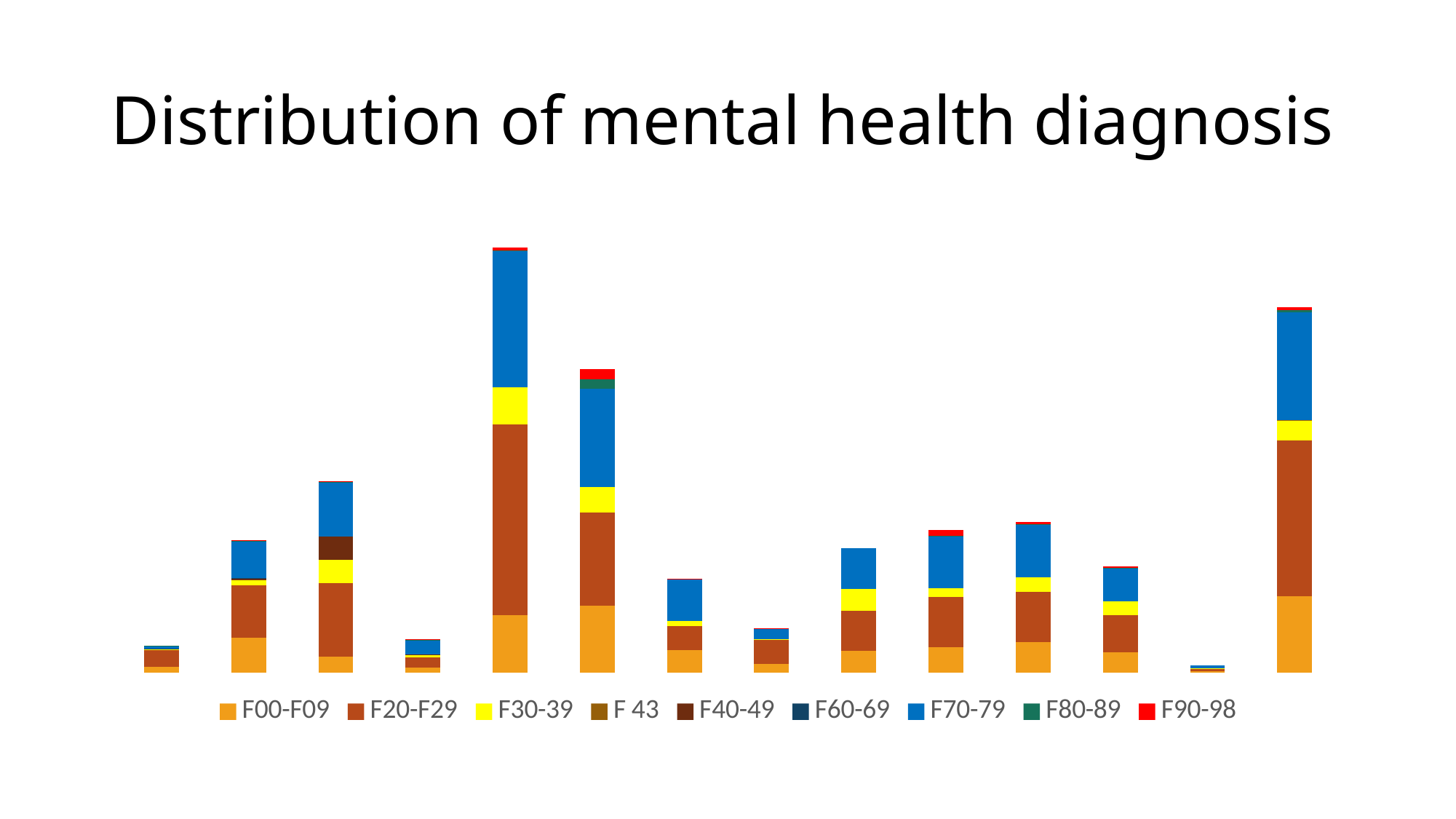
Which legend entry is shown in red? F90-98 Is the fifth bar from the left taller or shorter than the rightmost bar? Taller Which series forms the bottom segment of each stacked bar? F00-F09 What kind of chart is shown on the slide? Stacked bar chart Which bar, counted from the left, is the tallest? The fifth bar How many series does the legend list? 9 Is the second bar from the left taller or shorter than the third bar from the left? Shorter Which bar, counted from the left, is the shortest? The thirteenth bar How many bars are plotted in the chart? 14 What is the title of the chart? Distribution of mental health diagnosis